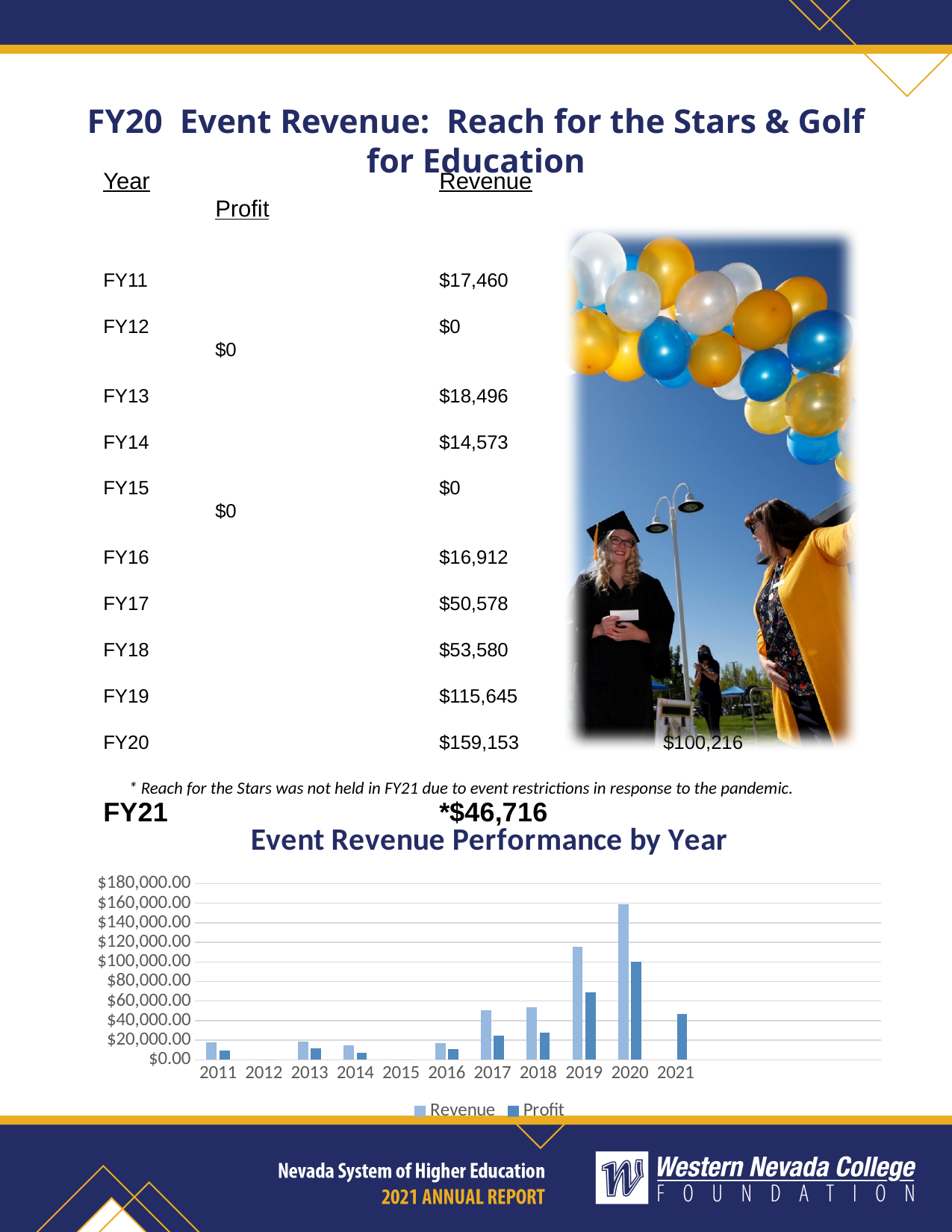
In the 'Event Revenue Performance by Year' chart, which is larger: the Profit for 2019 or the Profit for 2018? 2019 In the 'Event Revenue Performance by Year' chart, which year has the highest Profit? 2020 In the 'Event Revenue Performance by Year' chart, is the Profit for 2017 greater or less than $40,000.00? less In the 'Event Revenue Performance by Year' chart, is the Revenue for 2019 greater or less than $100,000.00? greater How many series does the legend of the 'Event Revenue Performance by Year' chart list? 2 In the 'Event Revenue Performance by Year' chart, does Revenue rise or fall from 2016 to 2020? Rise In the 'Event Revenue Performance by Year' chart, which years show no Revenue bar at all? 2012, 2015 and 2021 What are the two series named in the legend of the 'Event Revenue Performance by Year' chart? Revenue and Profit In the 'Event Revenue Performance by Year' chart, is the Profit for 2021 greater or less than $40,000.00? greater How many years are shown on the x axis of the 'Event Revenue Performance by Year' chart? 11 In the 'Event Revenue Performance by Year' chart, which year has the highest Revenue? 2020 What kind of chart is 'Event Revenue Performance by Year'? Bar chart